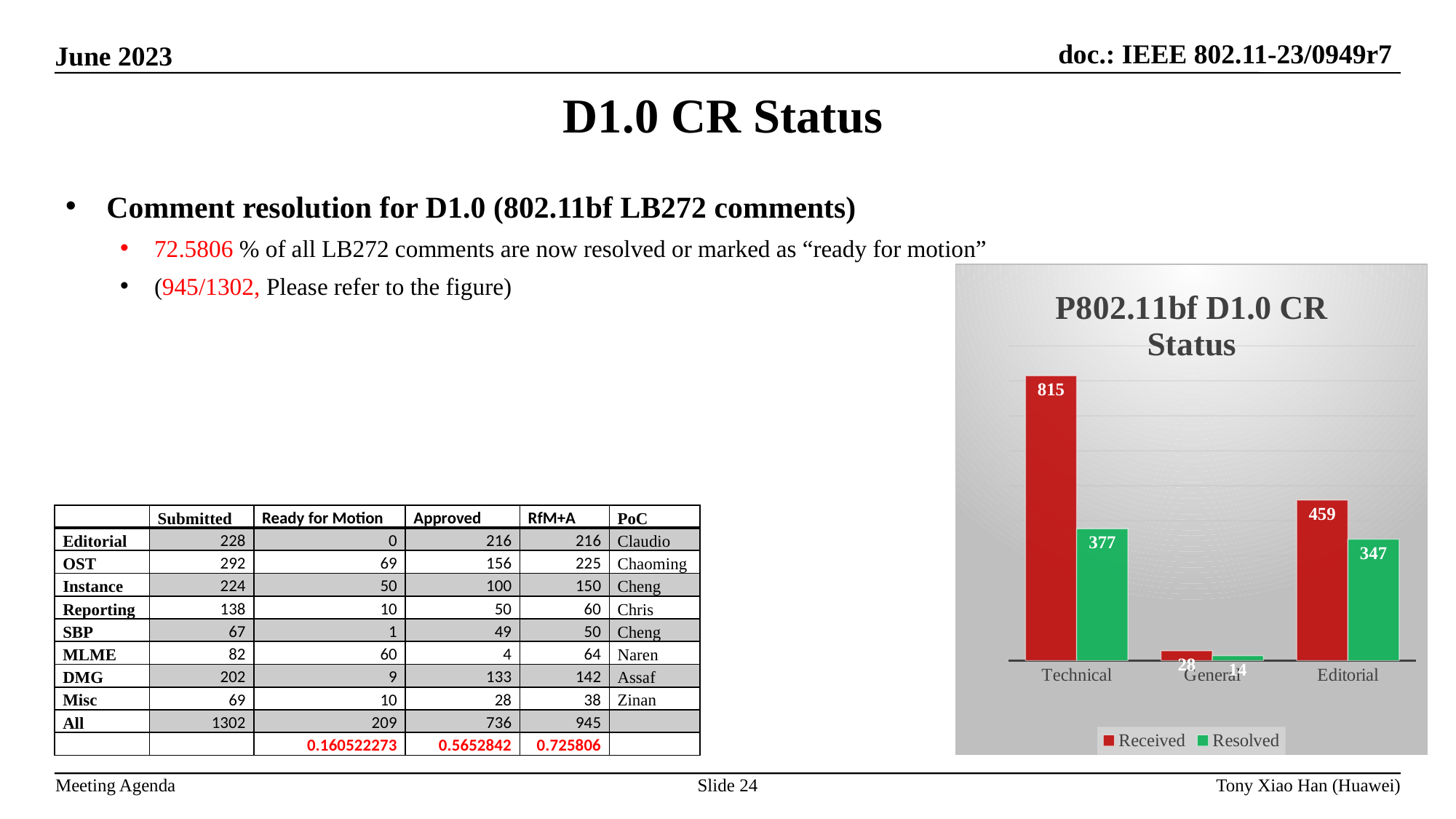
What is the Received value for Technical in the P802.11bf D1.0 CR Status chart? 815 What is the Resolved value for Editorial in the chart? 347 Which category has the lowest Resolved value in the chart? General What type of chart is shown on the slide? Bar chart How many categories are shown on the x axis of the chart? 3 What is the Resolved value for Technical in the chart? 377 Which is larger in the chart: the Resolved value for Editorial or the Resolved value for Technical? Resolved value for Technical What is the Received value for General in the chart? 28 Which category has the highest Received value in the chart? Technical What is the difference between Received and Resolved for Technical in the chart? 438 How many series does the chart legend list? 2 What is the difference between Received and Resolved for Editorial in the chart? 112